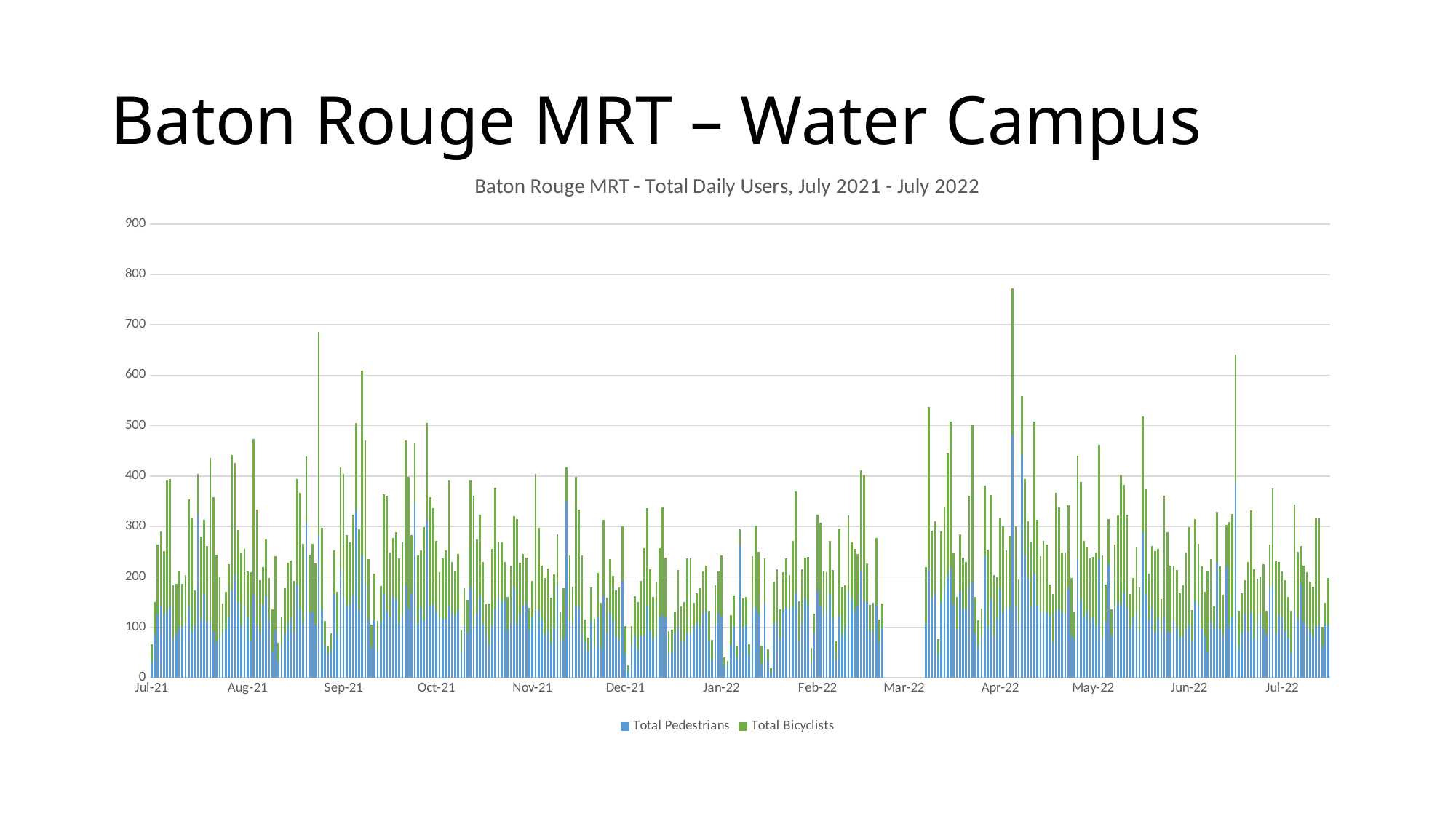
Is the tallest bar in the chart greater or less than 700? greater In which month does the tallest bar of the whole chart occur? Apr-22 What is the title of the chart? Baton Rouge MRT - Total Daily Users, July 2021 - July 2022 What kind of chart is shown on the slide? Stacked bar chart Is the tallest bar in the chart greater or less than 800? less Which is taller: the tallest bar in April 2022 or the tallest bar in August 2021? April 2022 What are the two series named in the legend? Total Pedestrians and Total Bicyclists Is the tallest bar in January 2022 greater or less than 400? less How many series does the legend list? 2